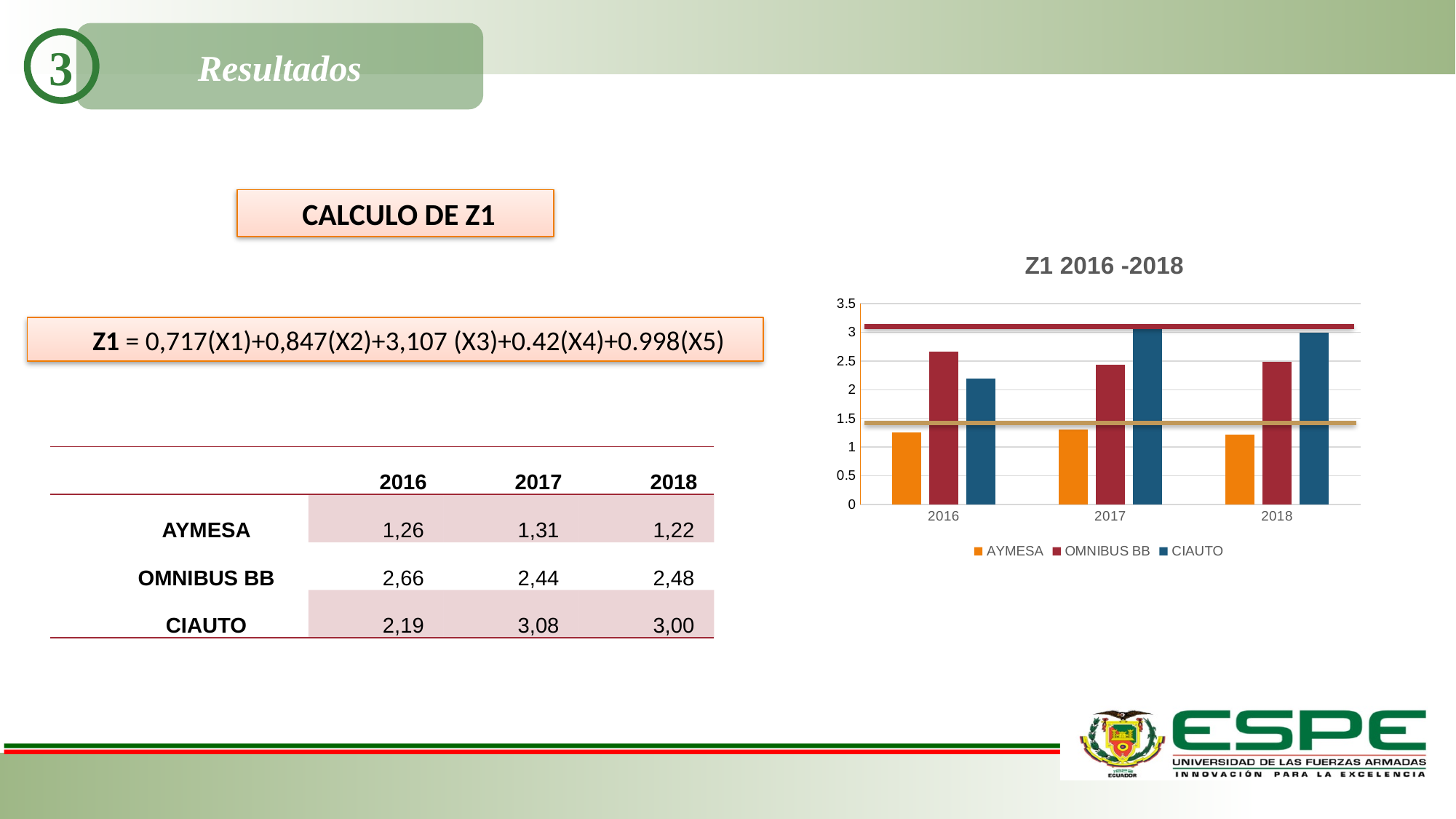
What kind of chart is shown under the title "Z1 2016 -2018"? bar chart What is the difference between the Z1 values of OMNIBUS BB and AYMESA in 2016, using the values printed in the table? 1,40 Which series has the highest value in 2017 in the "Z1 2016 -2018" chart? CIAUTO In the "Z1 2016 -2018" chart, is the value for OMNIBUS BB in 2016 larger than the value for CIAUTO in 2016? Yes How many year categories are shown on the x axis of the "Z1 2016 -2018" chart? 3 Which series has the lowest value in 2018 in the "Z1 2016 -2018" chart? AYMESA What is the value of Z1 for CIAUTO in 2017, as printed in the table? 3,08 Is the value for CIAUTO in 2017 greater or less than 3? greater How many series does the legend of the "Z1 2016 -2018" chart list? 3 Which series has the highest value in 2016 in the "Z1 2016 -2018" chart? OMNIBUS BB Is the value for AYMESA in 2018 greater or less than 1.5? less Which colour represents AYMESA in the "Z1 2016 -2018" chart? orange